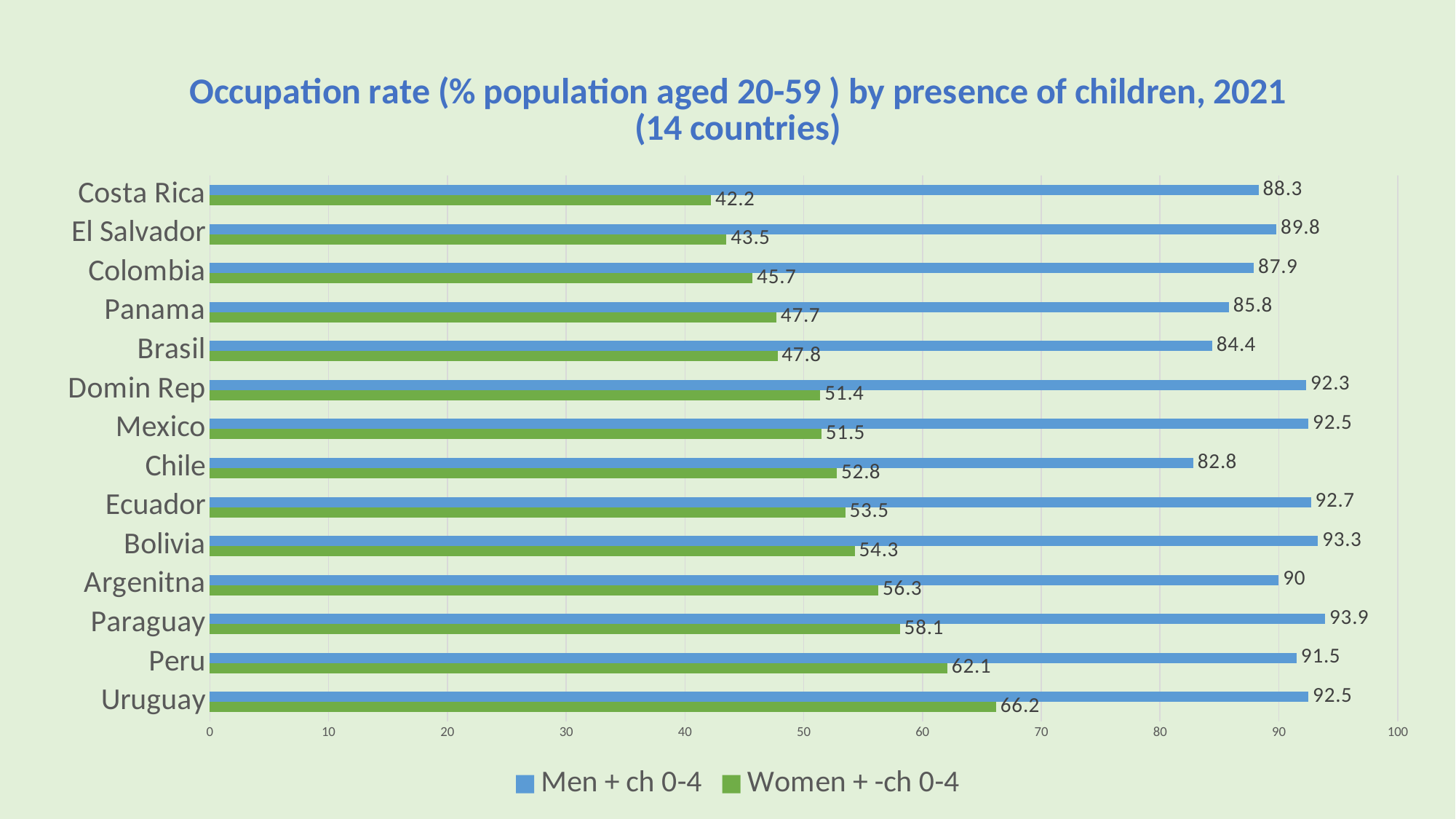
Which country has the lowest value for Women + -ch 0-4? Costa Rica Which is larger: the Women + -ch 0-4 value for Peru or for Paraguay? Peru What is the value for Women + -ch 0-4 in Uruguay? 66.2 What is the value for Men + ch 0-4 in Paraguay? 93.9 Which country has the lowest value for Men + ch 0-4? Chile Which country has the highest value for Men + ch 0-4? Paraguay How many countries are shown in the chart? 14 What is the difference between the Men + ch 0-4 and Women + -ch 0-4 values for Uruguay? 26.3 Is the Men + ch 0-4 value for Chile greater or less than 80? greater How many series does the legend list? 2 What kind of chart is shown on the slide? bar chart What is the value for Women + -ch 0-4 in Chile? 52.8